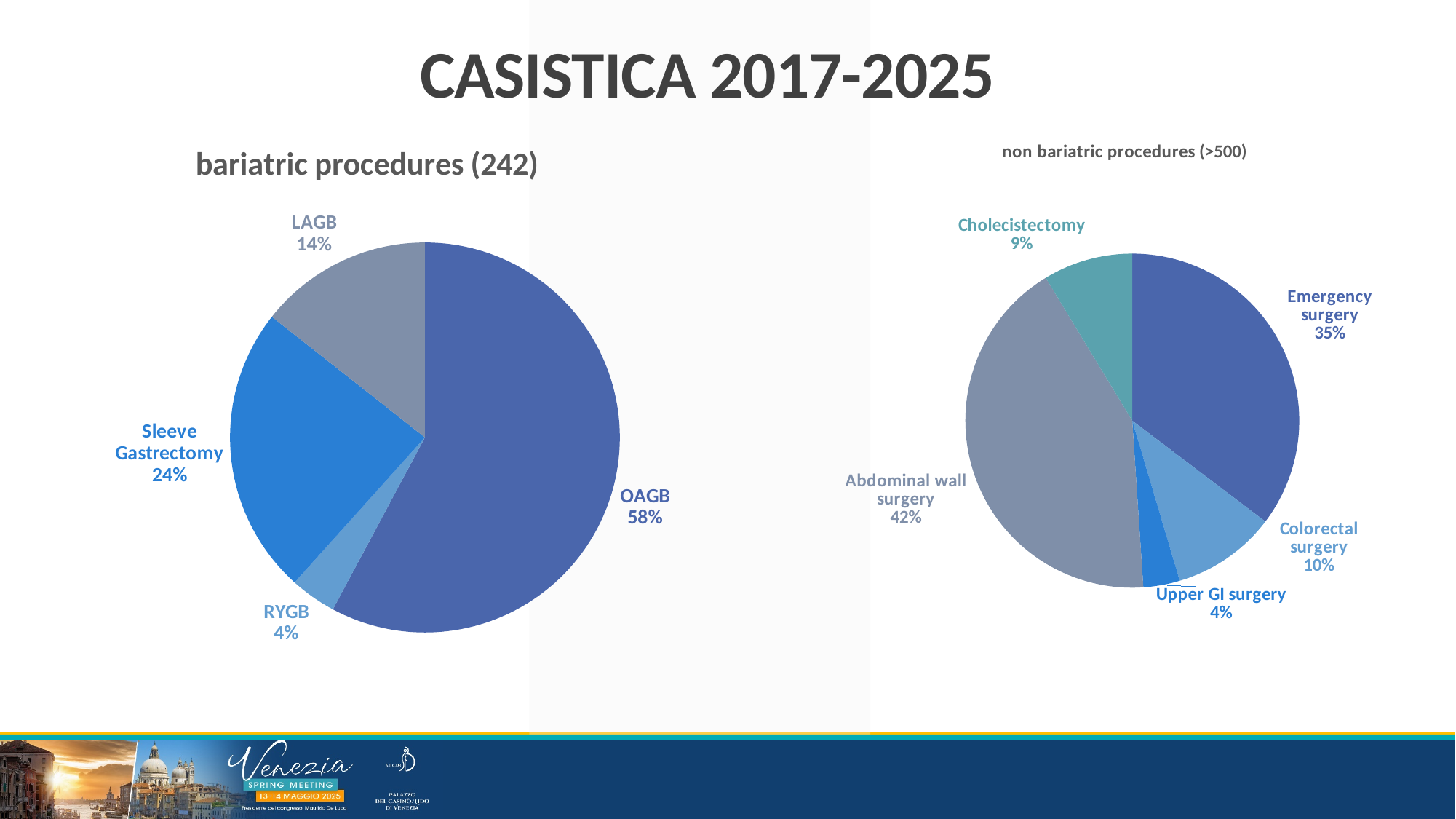
In the 'bariatric procedures (242)' chart, how many slices does the pie have? 4 In the 'non bariatric procedures (>500)' chart, how many categories are shown? 5 In the 'bariatric procedures (242)' chart, which procedure has the smallest share? RYGB In the 'bariatric procedures (242)' chart, what is the difference in percentage points between OAGB and Sleeve Gastrectomy? 34 In the 'bariatric procedures (242)' chart, what share does OAGB have? 58% In the 'non bariatric procedures (>500)' chart, what share does Abdominal wall surgery have? 42% In the 'bariatric procedures (242)' chart, what share does Sleeve Gastrectomy have? 24% In the 'non bariatric procedures (>500)' chart, which is larger, Emergency surgery or Colorectal surgery? Emergency surgery In the 'bariatric procedures (242)' chart, which procedure has the largest share? OAGB In the 'non bariatric procedures (>500)' chart, which category has the largest share? Abdominal wall surgery What type of chart is used for the 'non bariatric procedures (>500)' data? Pie chart In the 'non bariatric procedures (>500)' chart, what share does Cholecistectomy have? 9%